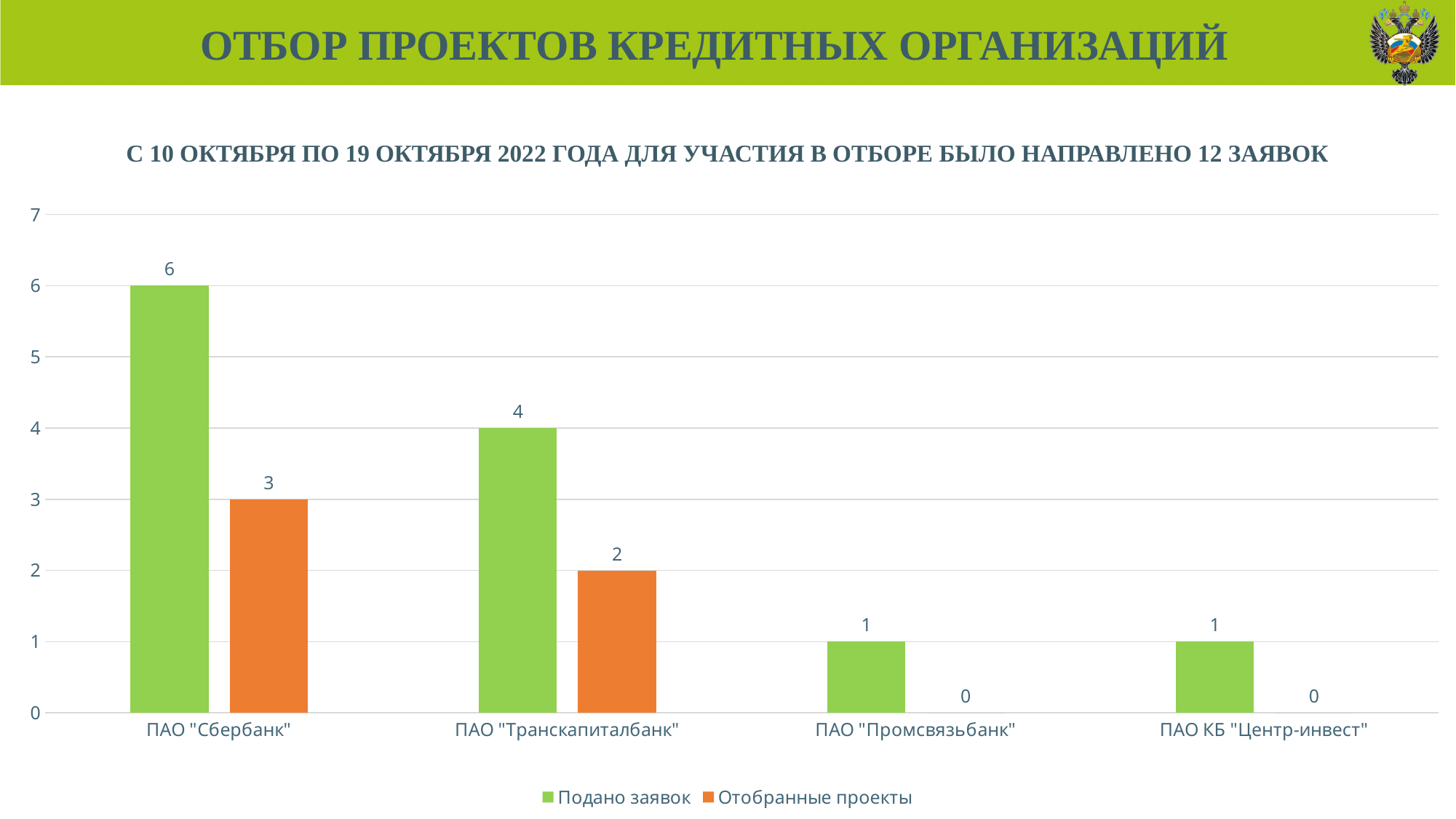
How many selected projects (Отобранные проекты) does ПАО КБ "Центр-инвест" have? 0 What is the difference in submitted applications (Подано заявок) between ПАО "Сбербанк" and ПАО "Транскапиталбанк"? 2 How many applications (Подано заявок) were submitted by ПАО "Сбербанк"? 6 How many series does the chart legend list? 2 What is the difference between submitted applications and selected projects for ПАО "Сбербанк"? 3 Which bank has the highest number of selected projects (Отобранные проекты)? ПАО "Сбербанк" Which colour represents the series "Отобранные проекты" in the chart? Orange What type of chart is shown on the slide? Bar chart Which bank has the highest number of submitted applications (Подано заявок)? ПАО "Сбербанк" How many selected projects (Отобранные проекты) does ПАО "Транскапиталбанк" have? 2 Which has more selected projects (Отобранные проекты): ПАО "Сбербанк" or ПАО "Транскапиталбанк"? ПАО "Сбербанк" How many banks (categories) are shown on the x axis of the chart? 4